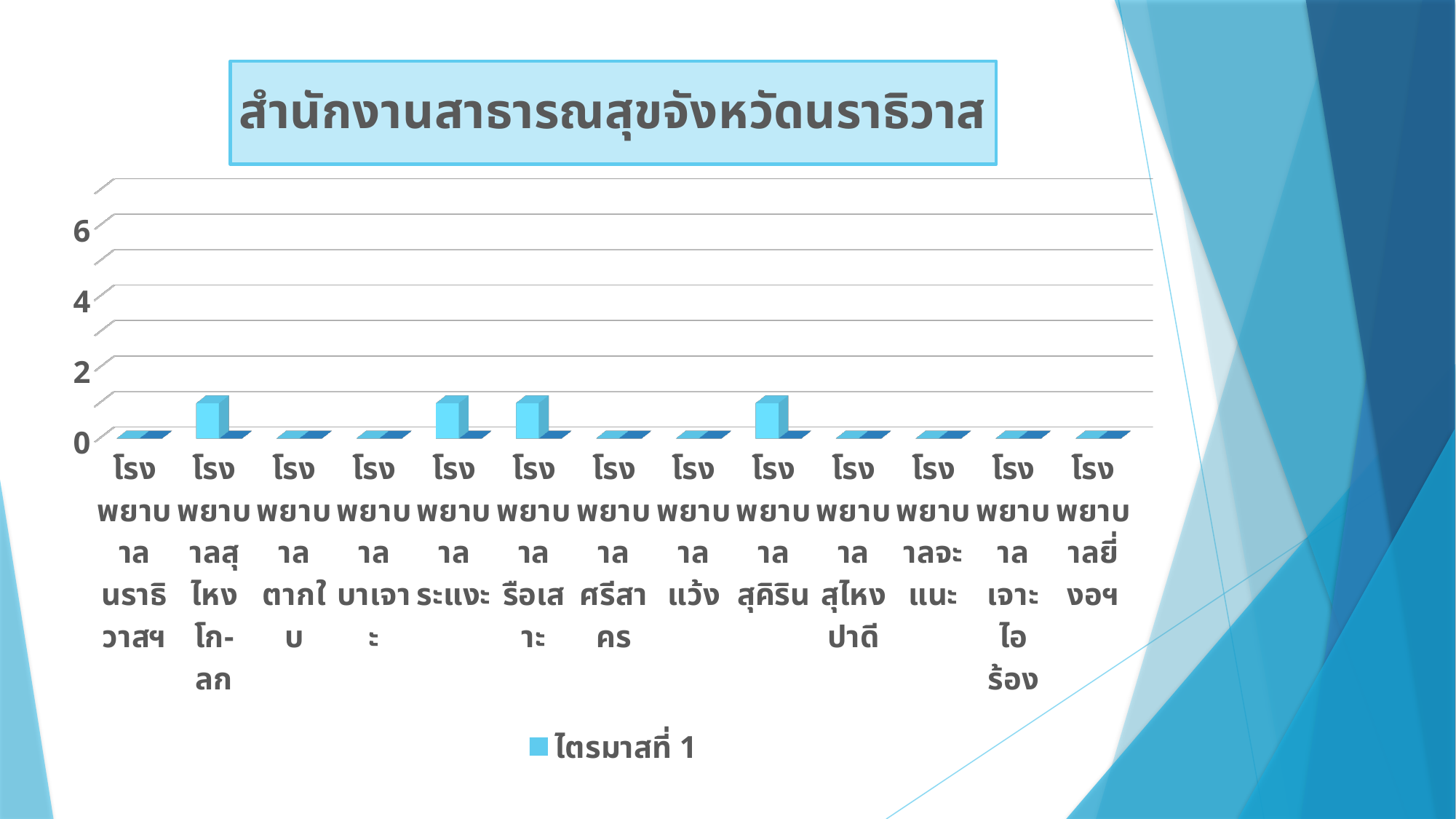
What kind of chart is shown on the slide? bar chart How many categories are shown on the x axis? 13 How many series does the legend list? 1 What is the value for โรงพยาบาลยี่งอฯ? 0 What is the value for โรงพยาบาลนราธิวาสฯ? 0 Is the value for โรงพยาบาลสุไหงโก-ลก greater or less than 2? less How many categories have a bar above 0? 4 What is the title of the chart? สำนักงานสาธารณสุขจังหวัดนราธิวาส Which is larger, the value for โรงพยาบาลระแงะ or the value for โรงพยาบาลศรีสาคร? โรงพยาบาลระแงะ What is the name of the series shown in the legend? ไตรมาสที่ 1 What is the value for โรงพยาบาลตากใบ? 0 Is the value for โรงพยาบาลสุคิริน greater or less than 4? less